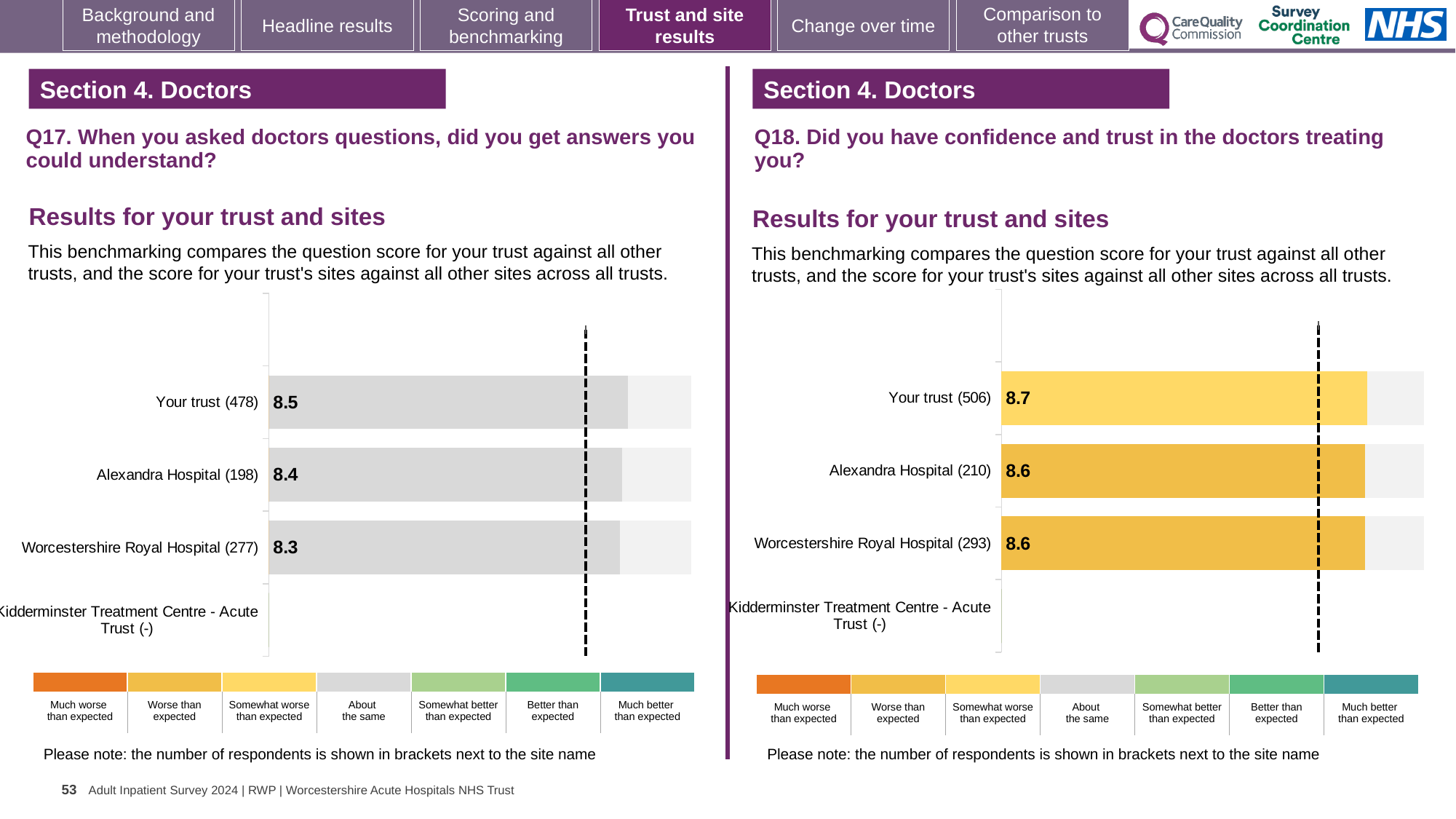
On the Q17 chart, which has the higher score, Your trust (478) or Alexandra Hospital (198)? Your trust (478) What kind of chart is used for the Q17 results? Bar chart On the Q17 chart, what is the score for Your trust (478)? 8.5 On the Q18 chart, what is the score for Your trust (506)? 8.7 How many categories are listed on the vertical axis of the Q18 chart? 4 On the Q18 chart, what is the difference between the scores for Your trust (506) and Alexandra Hospital (210)? 0.1 On the Q18 chart, which category has the highest score? Your trust (506) On the Q17 chart, what is the difference between the scores for Your trust (478) and Worcestershire Royal Hospital (277)? 0.2 On the Q18 chart, what is the score for Alexandra Hospital (210)? 8.6 On the Q17 chart, what is the score for Worcestershire Royal Hospital (277)? 8.3 On the Q18 chart, what colour are the bars for Alexandra Hospital (210) and Worcestershire Royal Hospital (293)? Yellow On the Q17 chart, which category has the lowest score? Worcestershire Royal Hospital (277)